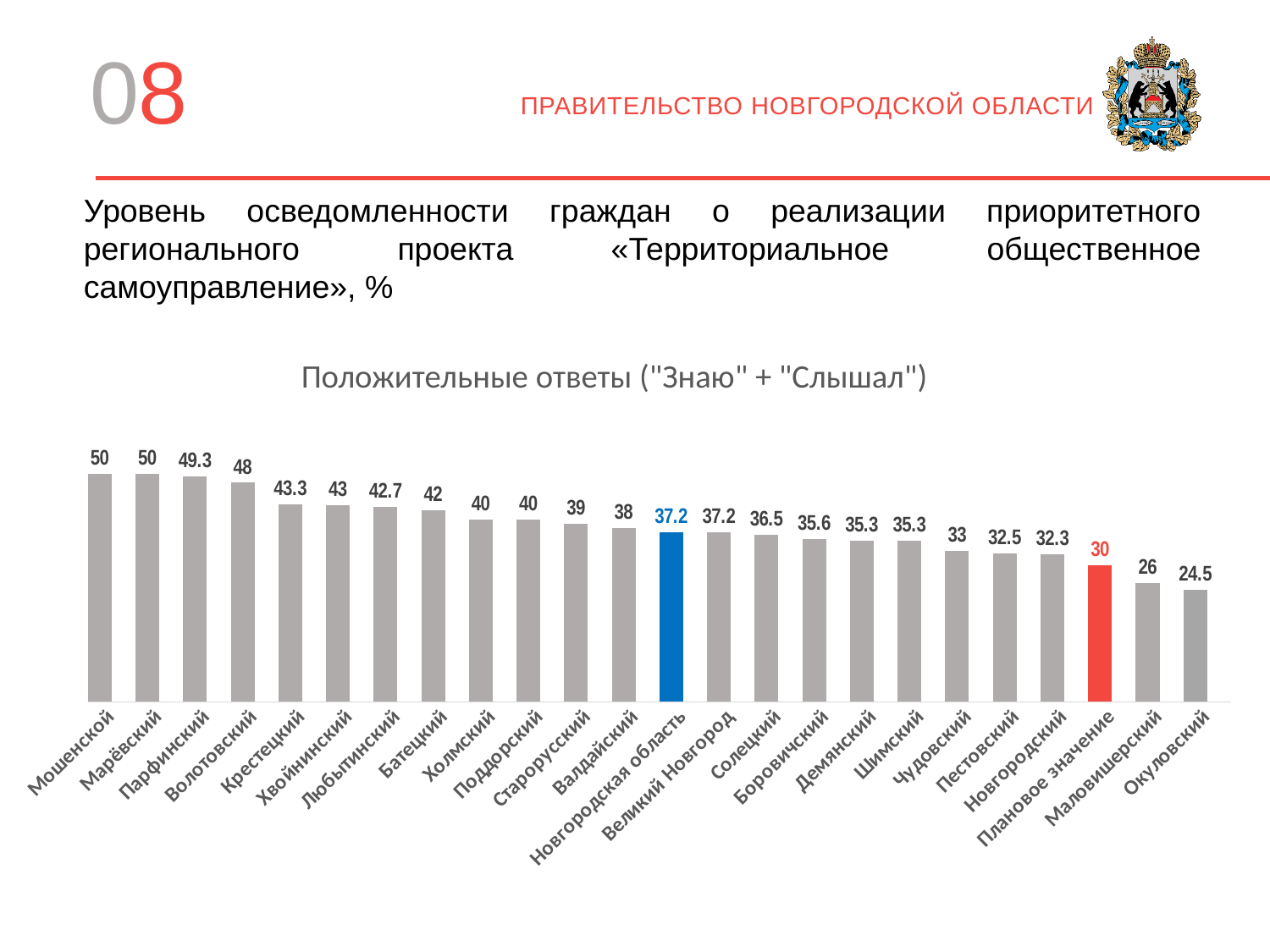
Which is larger, the value for Крестецкий or the value for Чудовский? Крестецкий How many bars are shown in the chart? 24 What is the difference between the values for Мошенской and Окуловский? 25.5 Do the values generally rise or fall from left to right along the x axis? Fall What is the difference between the values for Новгородская область and Плановое значение? 7.2 What is the value for Плановое значение? 30 Which category has the lowest value? Окуловский What is the value for Парфинский? 49.3 Which bar is coloured red? Плановое значение What is the value for Новгородская область? 37.2 What kind of chart is shown on the slide? Bar chart What is the value for Окуловский? 24.5